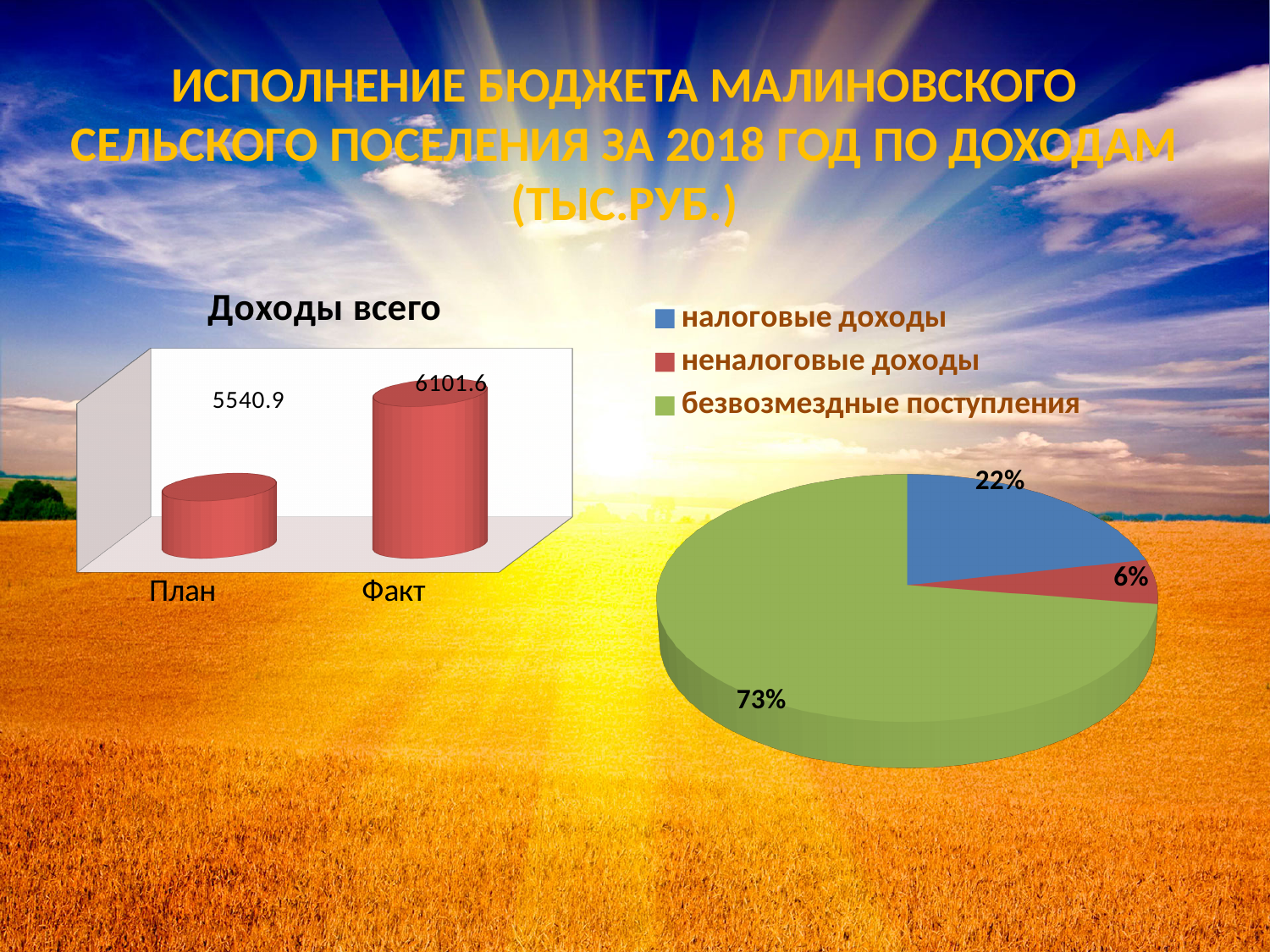
In the pie chart on the right, what share is безвозмездные поступления? 73% In the pie chart on the right, which category has the largest share? безвозмездные поступления In the "Доходы всего" chart, what is the difference between Факт and План? 560.7 In the "Доходы всего" chart, what is the value for План? 5540.9 In the "Доходы всего" chart, what is the value for Факт? 6101.6 In the pie chart on the right, what share is неналоговые доходы? 6% In the "Доходы всего" chart, which category has the higher value, План or Факт? Факт In the "Доходы всего" chart, how many categories are shown? 2 What kind of chart is the "Доходы всего" chart on the left? Bar chart In the pie chart on the right, which category has the smallest share? неналоговые доходы How many entries does the legend of the pie chart on the right list? 3 In the pie chart on the right, what share is налоговые доходы? 22%